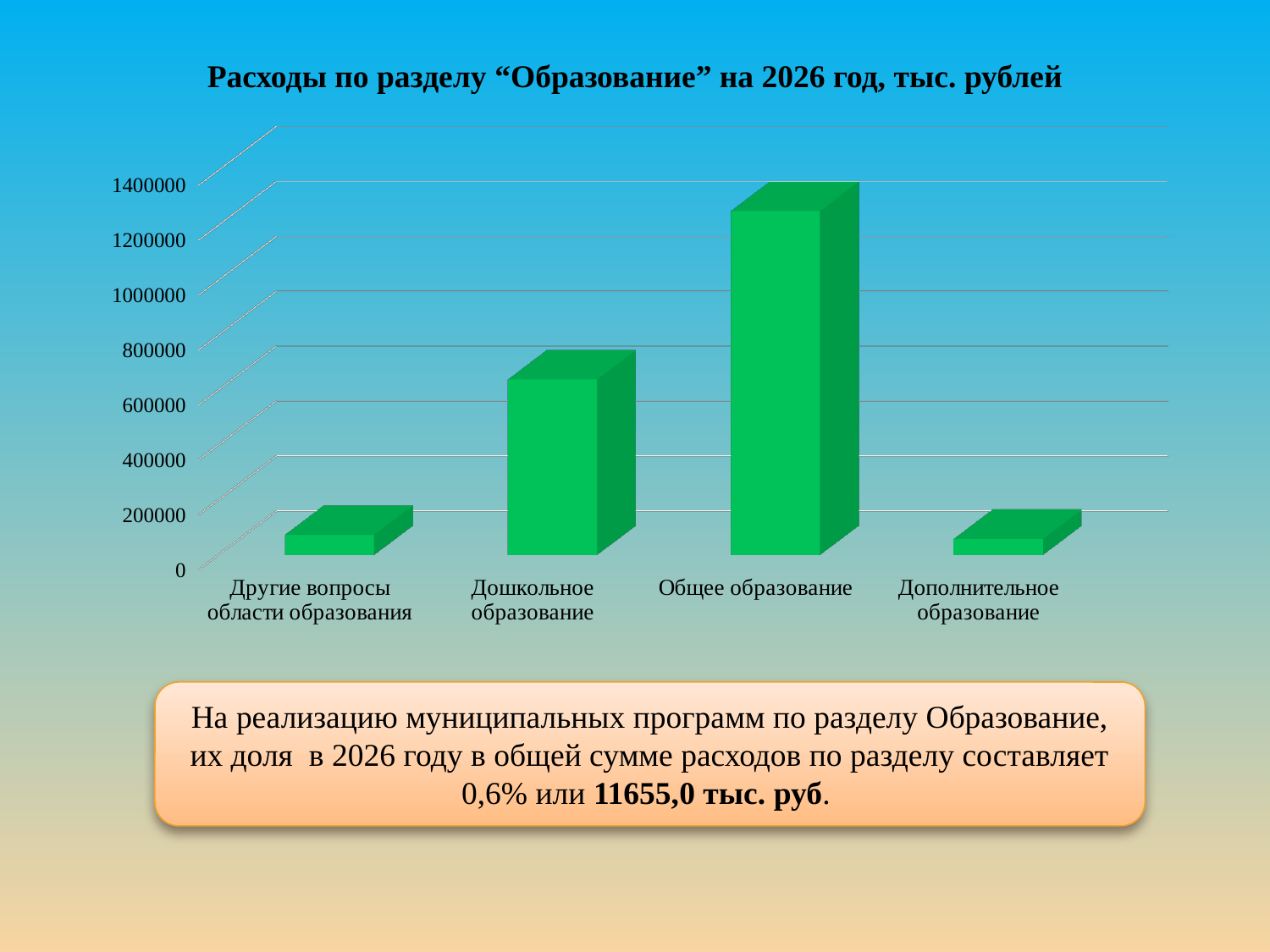
Which is larger, the value for Дошкольное образование or the value for Дополнительное образование? Дошкольное образование What is the title of the chart? Расходы по разделу “Образование” на 2026 год, тыс. рублей Which is larger, the value for Дошкольное образование or the value for Общее образование? Общее образование Which category has the highest value in the chart? Общее образование Is the value for Дополнительное образование greater or less than 200000? less Is the value for Дошкольное образование greater or less than 800000? less What kind of chart is shown on the slide? bar chart Is the value for Дошкольное образование greater or less than 600000? greater How many categories are shown on the x axis of the chart? 4 What colour are the bars in the chart? green